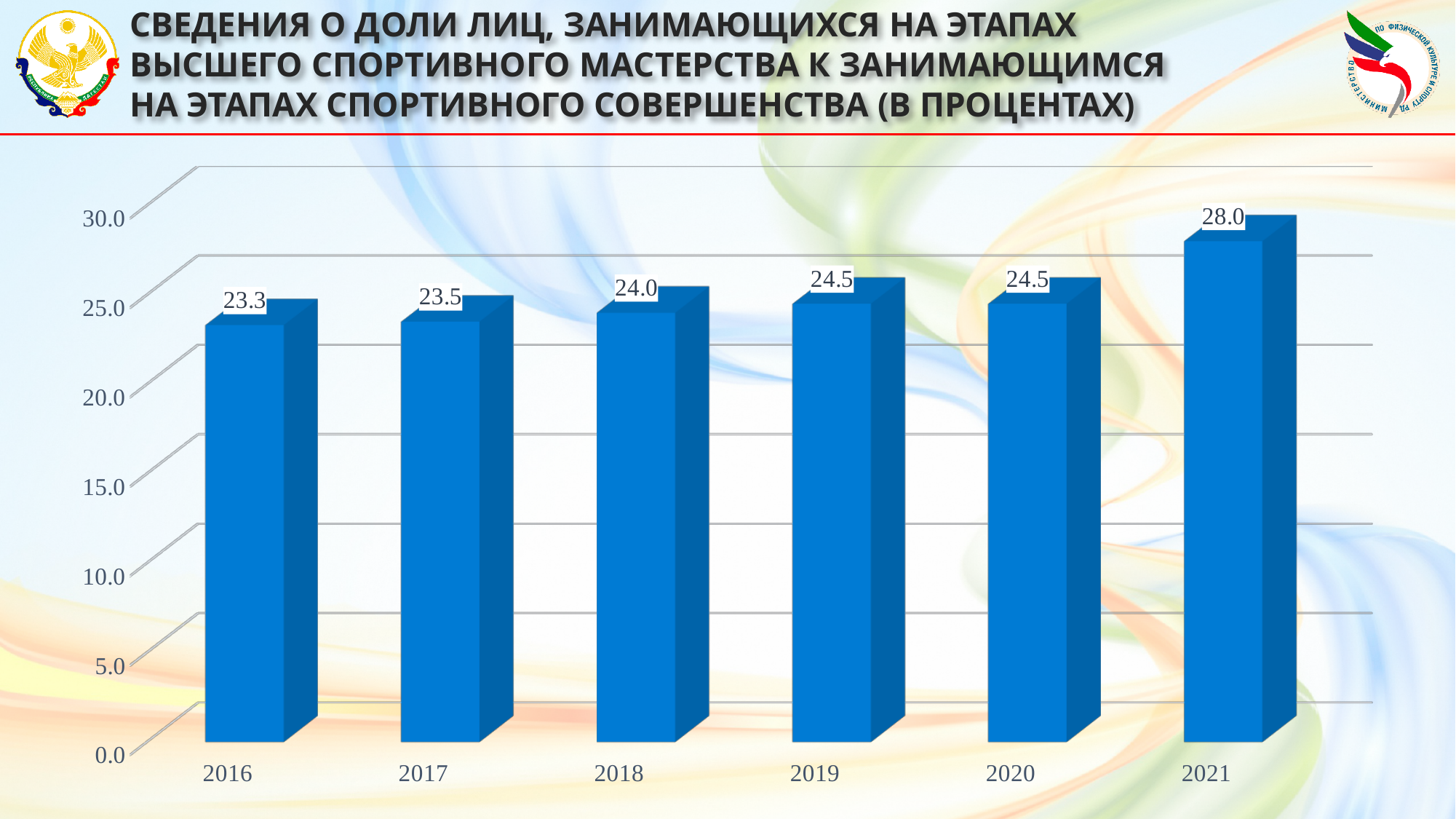
What is the value for 2021? 28.0 What is the value for 2018? 24.0 Which year has the lowest value? 2016 What is the value for 2016? 23.3 Is the value for 2020 greater or less than 20.0? greater What kind of chart is shown on the slide? bar chart Do the values rise or fall from 2016 to 2021? rise How many years are shown on the x axis? 6 Which is larger, the value for 2018 or the value for 2021? 2021 What is the difference between the values for 2019 and 2017? 1.0 Which year has the highest value? 2021 What is the difference between the values for 2021 and 2016? 4.7